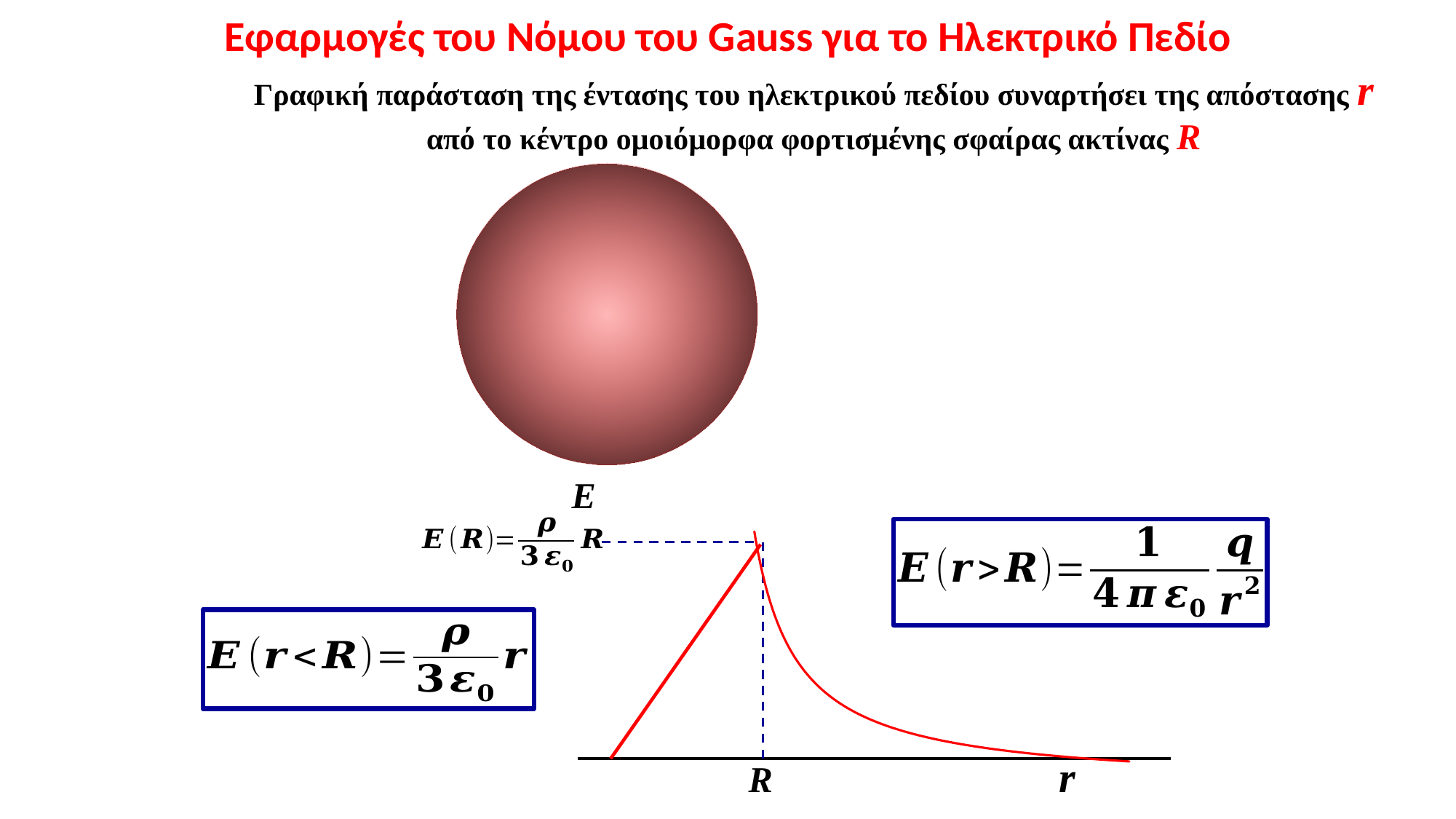
Does E rise or fall as r increases from 0 up to R? rises According to the slide, what is E for r > R? q/(4πε₀r²) How many curves are plotted on the graph? 1 At which value of r does the plotted E reach its maximum? R What kind of chart is shown at the bottom of the slide? line chart Is E larger at r = R or at the far right end of the r axis? at r = R According to the slide, what is E for r < R? ρr/3ε₀ What colour is the plotted E(r) curve? red What is the value of E at r = R, as labelled on the graph? ρR/3ε₀ What quantity is plotted on the horizontal axis of the graph? r Does E rise or fall as r increases beyond R? falls